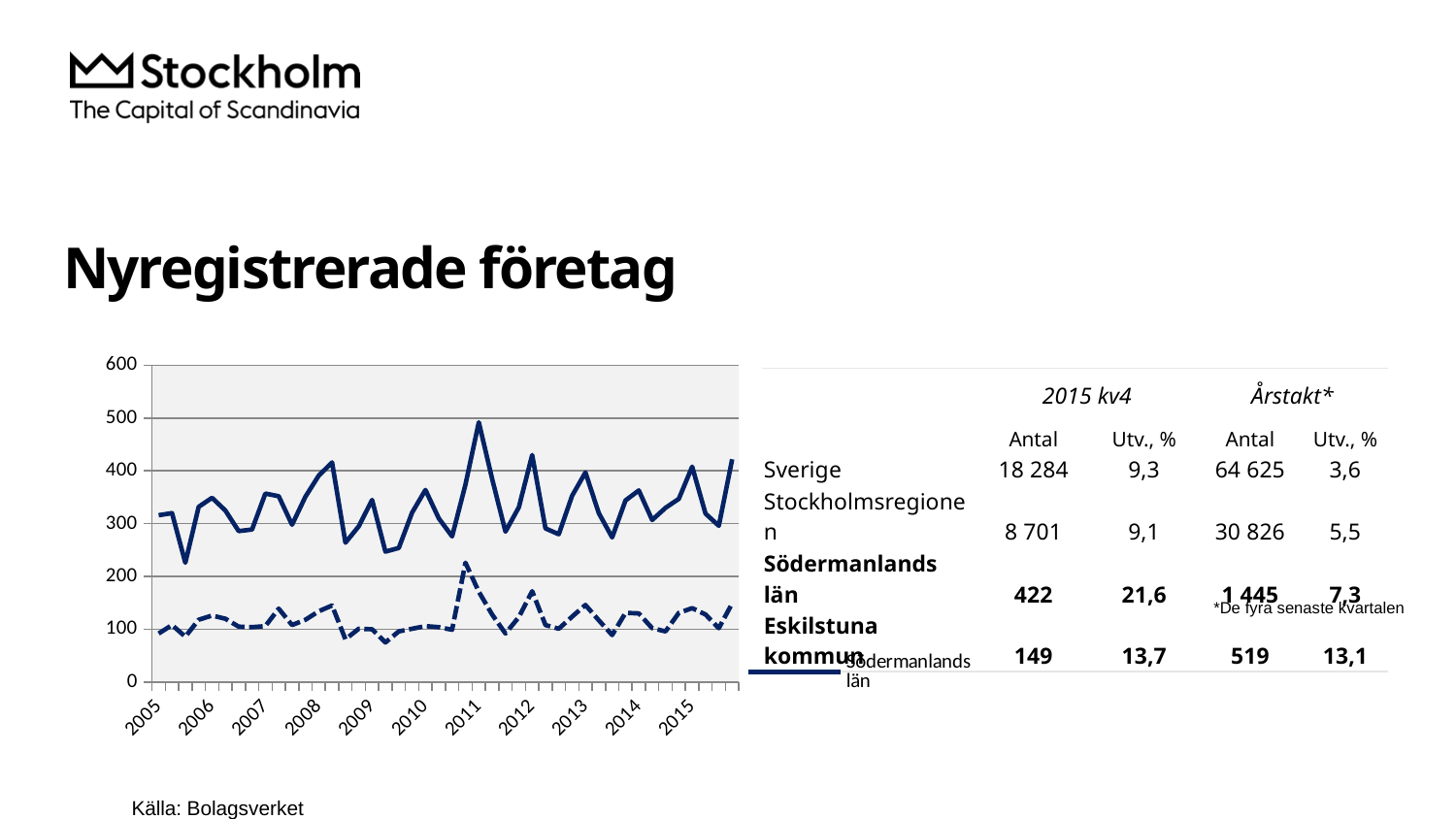
Does the solid line rise or fall between its low point in 2006 and its peak in 2008? rise In which year does the dashed line reach its highest peak? 2010 How many years are labelled on the x axis of the chart? 11 What is the highest value shown on the y axis of the chart? 600 Which series name is readable in the chart legend? Södermanlands län In which year does the solid line (Södermanlands län) reach its highest peak? 2011 Is the value of the solid line at the start of 2005 greater or less than 200? greater Is the value of the dashed line at the start of 2005 greater or less than 200? less What kind of chart is shown on the slide? line chart Is the peak value of the solid line in 2011 greater or less than 400? greater Which line is higher throughout the chart, the solid line or the dashed line? the solid line